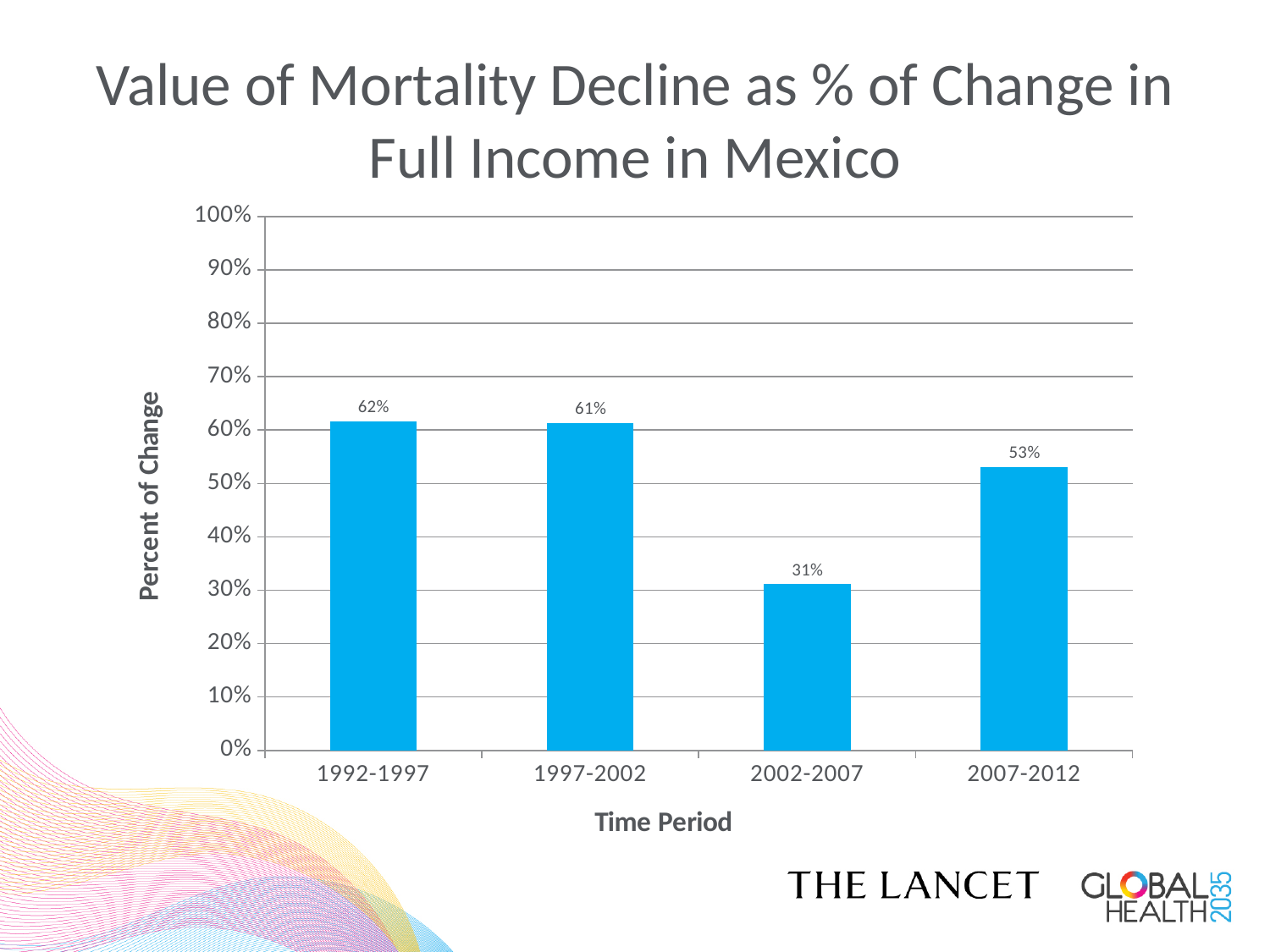
Which time period has the highest value? 1992-1997 What is the value for the 2002-2007 time period? 31% What is the difference between the values for 1992-1997 and 2002-2007? 31% Is the value for 2002-2007 greater or less than 40%? less Which time period has the lowest value? 2002-2007 Which is larger, the value for 1997-2002 or the value for 2007-2012? 1997-2002 What kind of chart is shown on the slide? bar chart What is the value for the 2007-2012 time period? 53% What is the value for the 1992-1997 time period? 62% What is the difference between the values for 2007-2012 and 2002-2007? 22% What is the label of the x axis? Time Period How many time periods are shown on the chart? 4